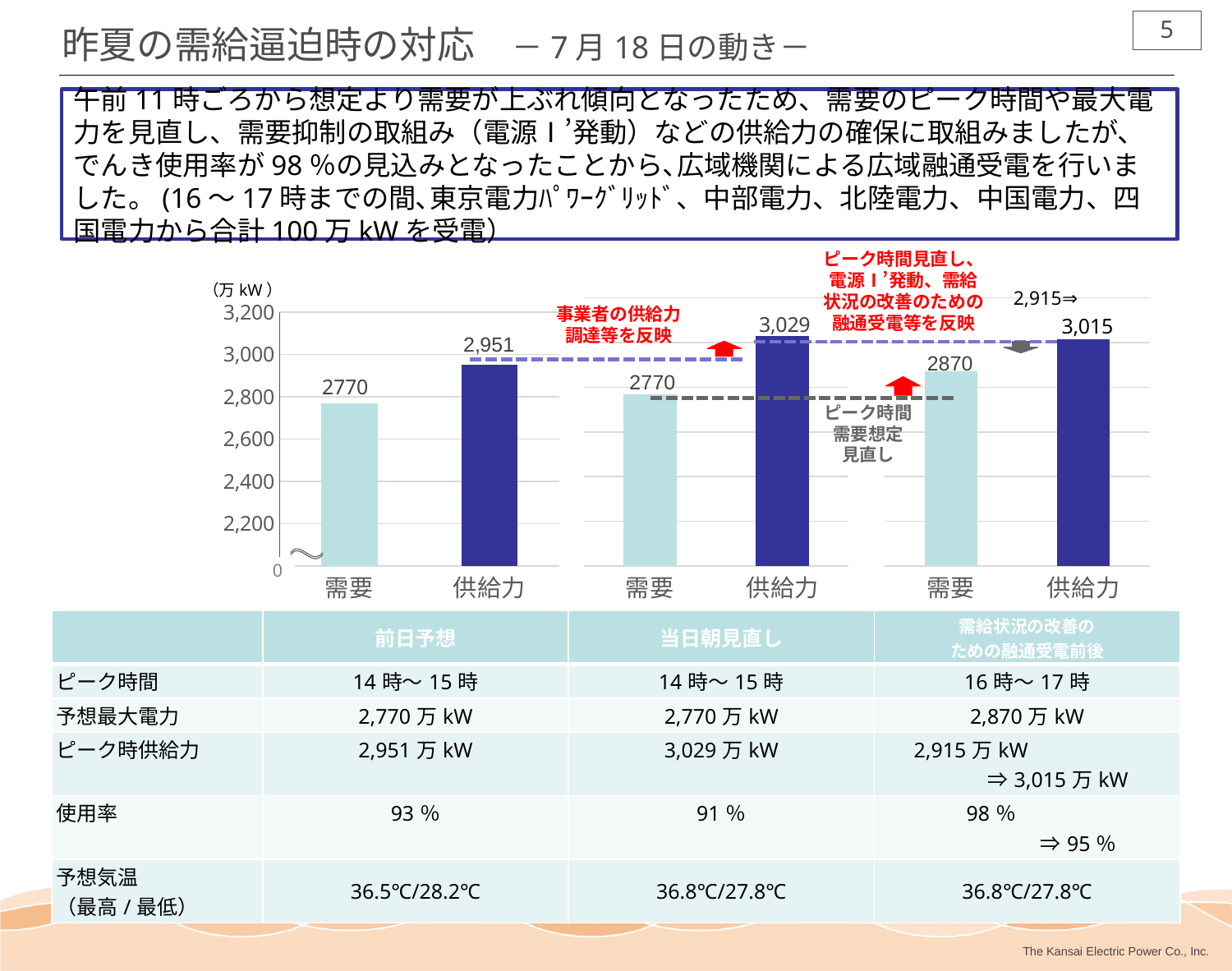
What is the value of the rightmost 供給力 bar in the chart? 3,015 What is the value of the 供給力 bar in the leftmost pair of bars? 2,951 How many bars are plotted in the chart? 6 What unit is shown at the top of the chart's vertical axis? 万kW What is the value of the 需要 bar in the rightmost pair of bars? 2870 What is the value of the 供給力 bar in the middle pair of bars? 3,029 In the middle pair of bars, what is the difference between the 供給力 value and the 需要 value? 259 Which is larger: the 需要 bar in the rightmost pair or the 需要 bar in the leftmost pair? The rightmost pair's 需要 bar What is the value of the leftmost 需要 bar in the chart? 2770 Among the three 需要 bars, which pair has the highest 需要 value? The rightmost pair (2870) What type of chart is shown on the slide? Bar chart In the leftmost pair of bars, how much larger is 供給力 than 需要? 181